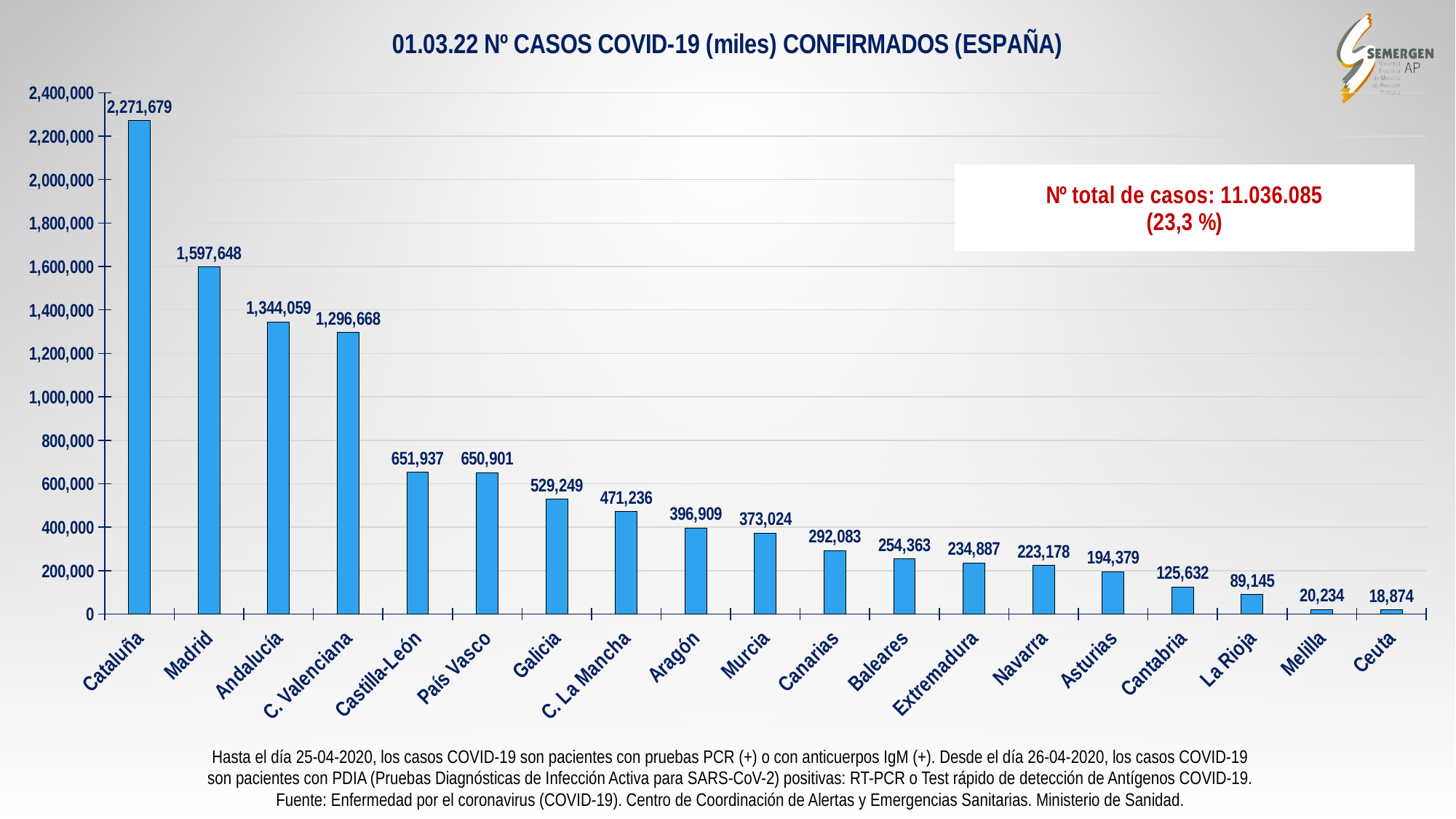
What is the difference between the values for Galicia and Aragón? 132,340 What is the value shown for Galicia? 529,249 What kind of chart is shown on the slide? bar chart Which region has the highest number of confirmed cases? Cataluña Which has more confirmed cases, Galicia or Murcia? Galicia What is the difference between the values for Cataluña and Madrid? 674,031 Which region has the lowest number of confirmed cases? Ceuta Is the value for Andalucía greater or less than 1,200,000? greater What is the value shown for Cantabria? 125,632 Do the bar values rise or fall from left to right along the x axis? fall How many regions are shown on the x axis of the chart? 19 How many confirmed COVID-19 cases does the chart show for Madrid? 1,597,648